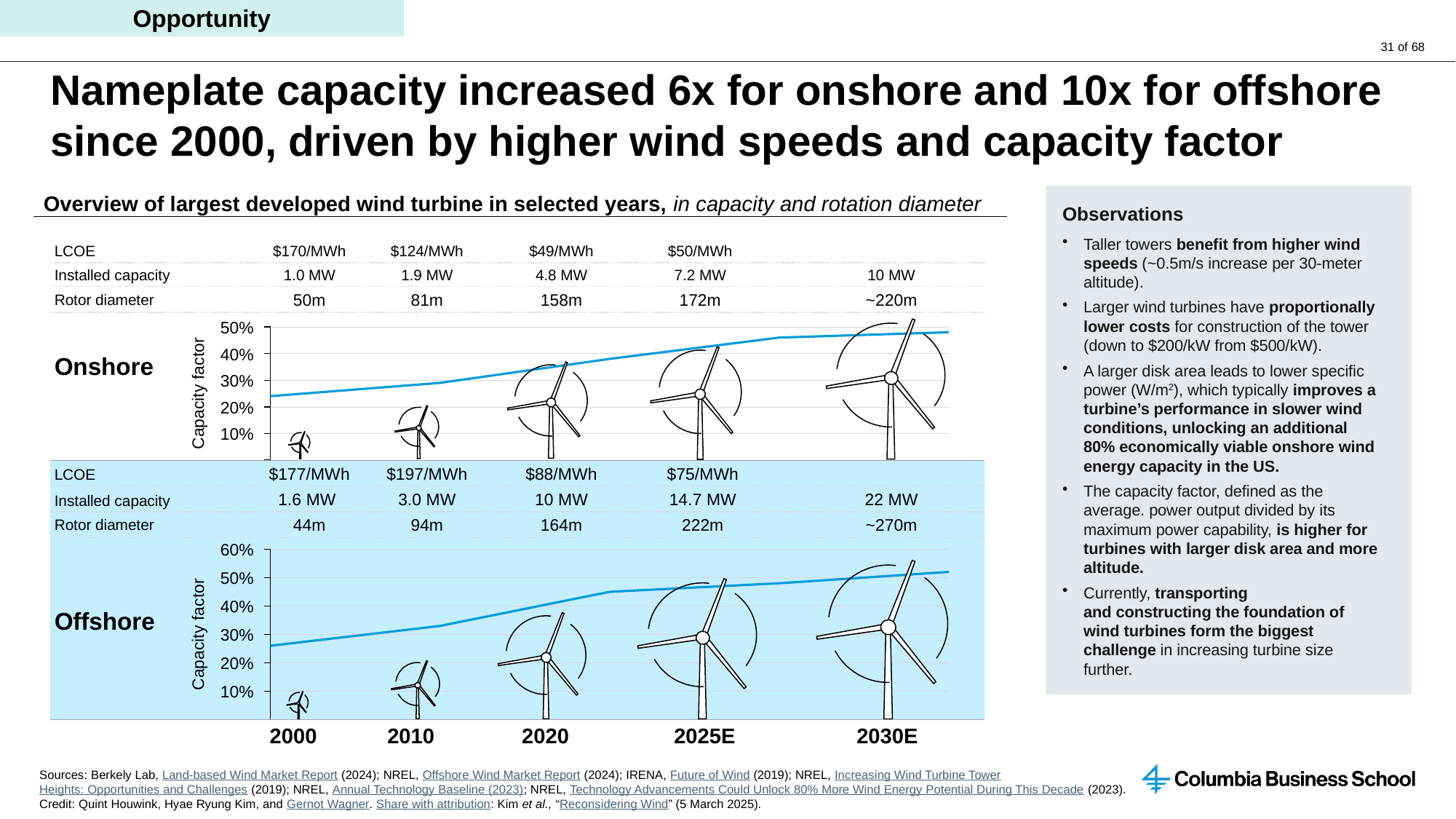
In the Onshore chart, is the capacity factor for 2000 greater or less than 20%? greater How many years are shown along the x axis of the charts? 5 In the Offshore panel, what is the rotor diameter for 2025E? 222m In the Offshore panel, what is the LCOE for 2010? $197/MWh What type of chart is used to show the capacity factor in the Onshore and Offshore panels? line chart In the Onshore chart, does the capacity factor rise or fall from 2000 to 2030E? rise In the Offshore chart, is the capacity factor for 2020 greater or less than 40%? greater In the Offshore chart, is the capacity factor for 2000 greater or less than 30%? less In the Onshore panel, what is the installed capacity for 2020? 4.8 MW In the Onshore panel, which year has the lowest LCOE? 2020 What is the difference between the Offshore and Onshore installed capacity for 2030E? 12 MW In the Offshore panel, which is larger, the LCOE for 2000 or for 2010? 2010